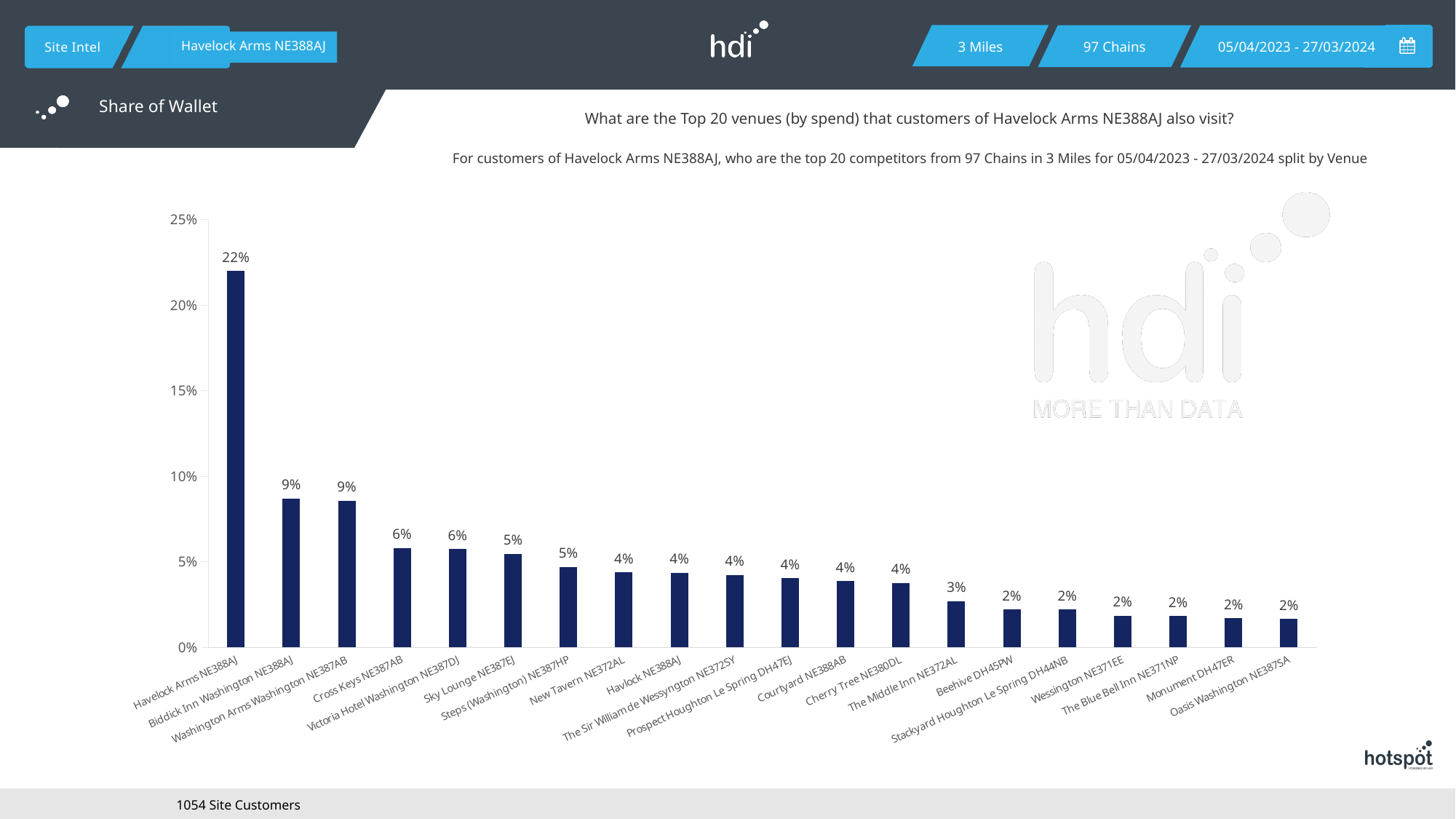
What is the value for Havelock Arms NE388AJ? 22% What is the value for Sky Lounge NE387EJ? 5% What is the difference between the values for Havelock Arms NE388AJ and Biddick Inn Washington NE388AJ? 13% How many venues are shown on the chart? 20 What is the value for Cross Keys NE387AB? 6% Which venue has the highest value? Havelock Arms NE388AJ Which is larger, the value for Cross Keys NE387AB or the value for Beehive DH45PW? Cross Keys NE387AB What is the number of site customers shown at the bottom of the slide? 1054 Site Customers Is the value for Havelock Arms NE388AJ greater or less than 20%? greater What kind of chart is shown on the slide? bar chart What is the value for The Middle Inn NE372AL? 3% Do the values rise or fall from left to right along the x axis? fall